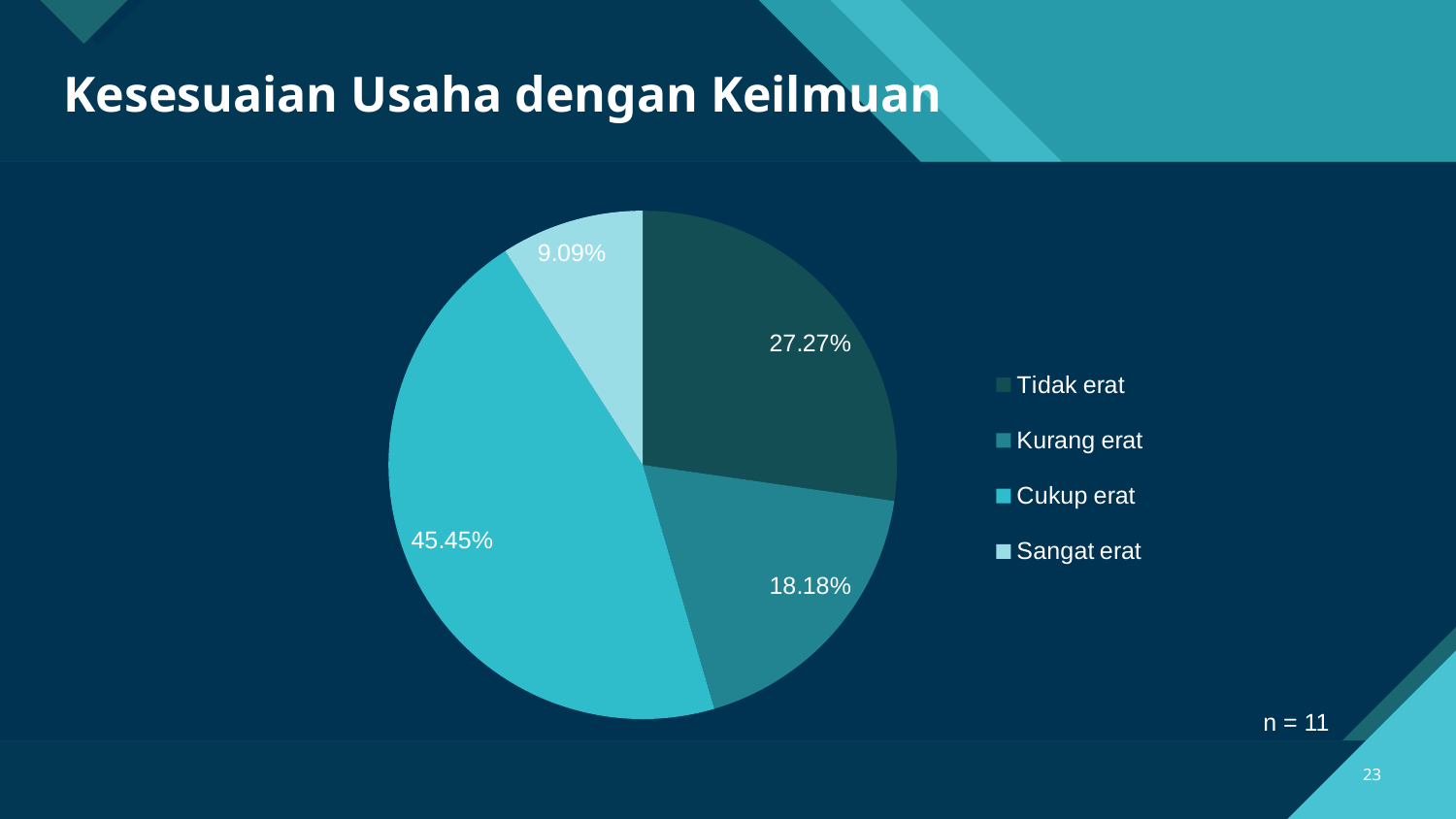
What percentage is shown for the Cukup erat slice? 45.45% What kind of chart is shown on the slide? pie chart What is the sample size (n) shown on the slide? n = 11 What is the difference between the Cukup erat share and the Sangat erat share? 36.36% What percentage is shown for the Sangat erat slice? 9.09% Which is larger, the Sangat erat share or the Kurang erat share? Kurang erat What percentage is shown for the Kurang erat slice? 18.18% Which category has the smallest share of the pie? Sangat erat What is the title of the slide containing the pie chart? Kesesuaian Usaha dengan Keilmuan Which category has the largest share of the pie? Cukup erat What percentage is shown for the Tidak erat slice? 27.27% How many categories does the legend of the pie chart list? 4